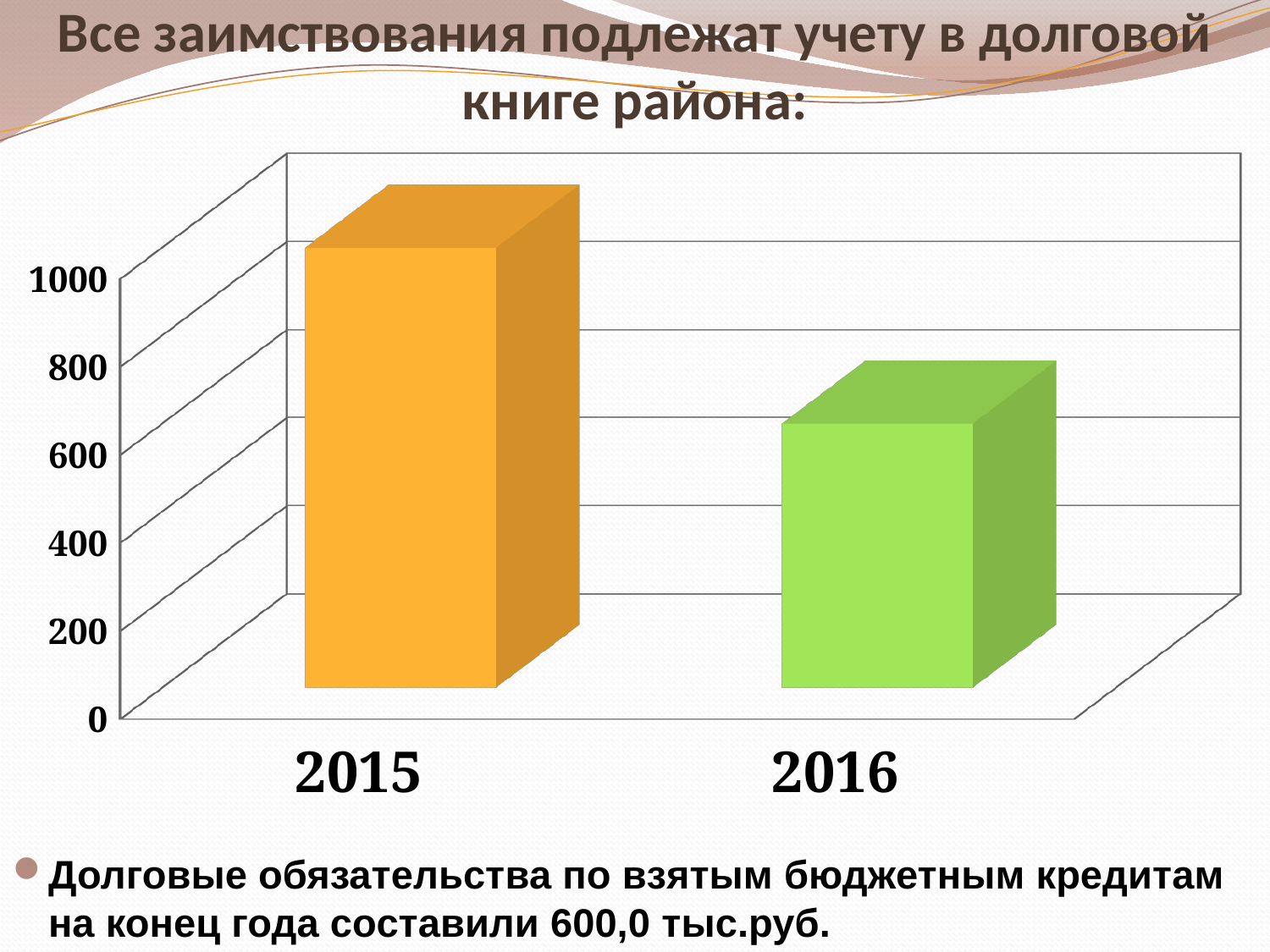
Do the values rise or fall from 2015 to 2016? fall Which is larger, the value for 2015 or the value for 2016? 2015 Is the value for 2015 greater or less than 800? greater How many categories (years) are shown on the x axis of the chart? 2 What is the highest tick value shown on the vertical axis of the chart? 1000 What kind of chart is shown on the slide? bar chart Is the value for 2016 greater or less than 400? greater Which year has the lowest bar in the chart? 2016 What colour is the bar for 2016? green Which year has the highest bar in the chart? 2015 Is the value for 2016 greater or less than 800? less